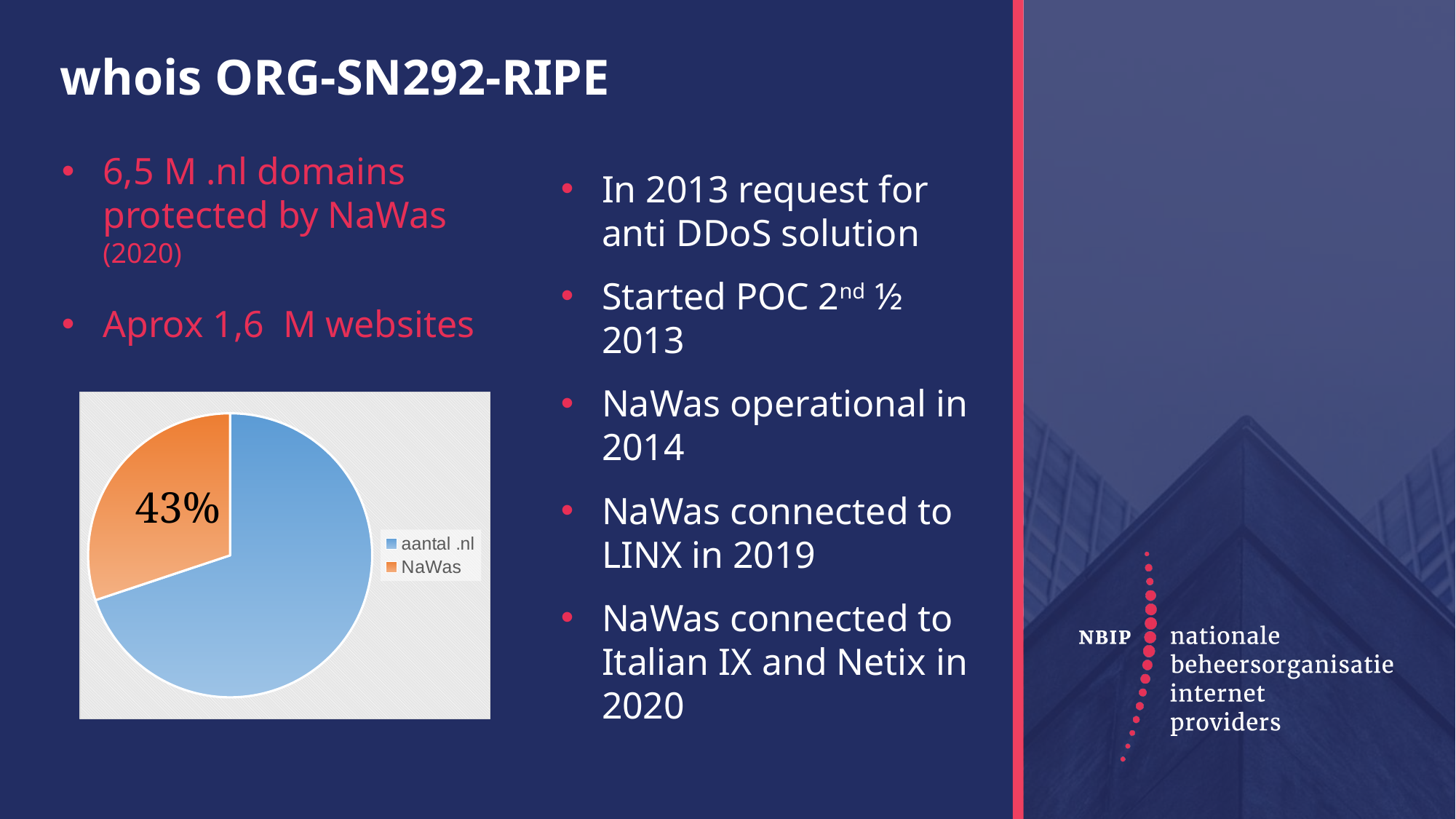
Which legend entry is shown in blue in the pie chart? aantal .nl How many entries does the pie chart's legend list? 2 What percentage is printed on the NaWas slice of the pie chart? 43% How many slices does the pie chart have? 2 Which slice of the pie chart is larger, aantal .nl or NaWas? aantal .nl Which category has the smallest slice in the pie chart? NaWas What kind of chart is shown on the slide? pie chart What colour is the NaWas slice in the pie chart? orange Which category has the largest slice in the pie chart? aantal .nl Is the share shown for the NaWas slice greater or less than 50%? less